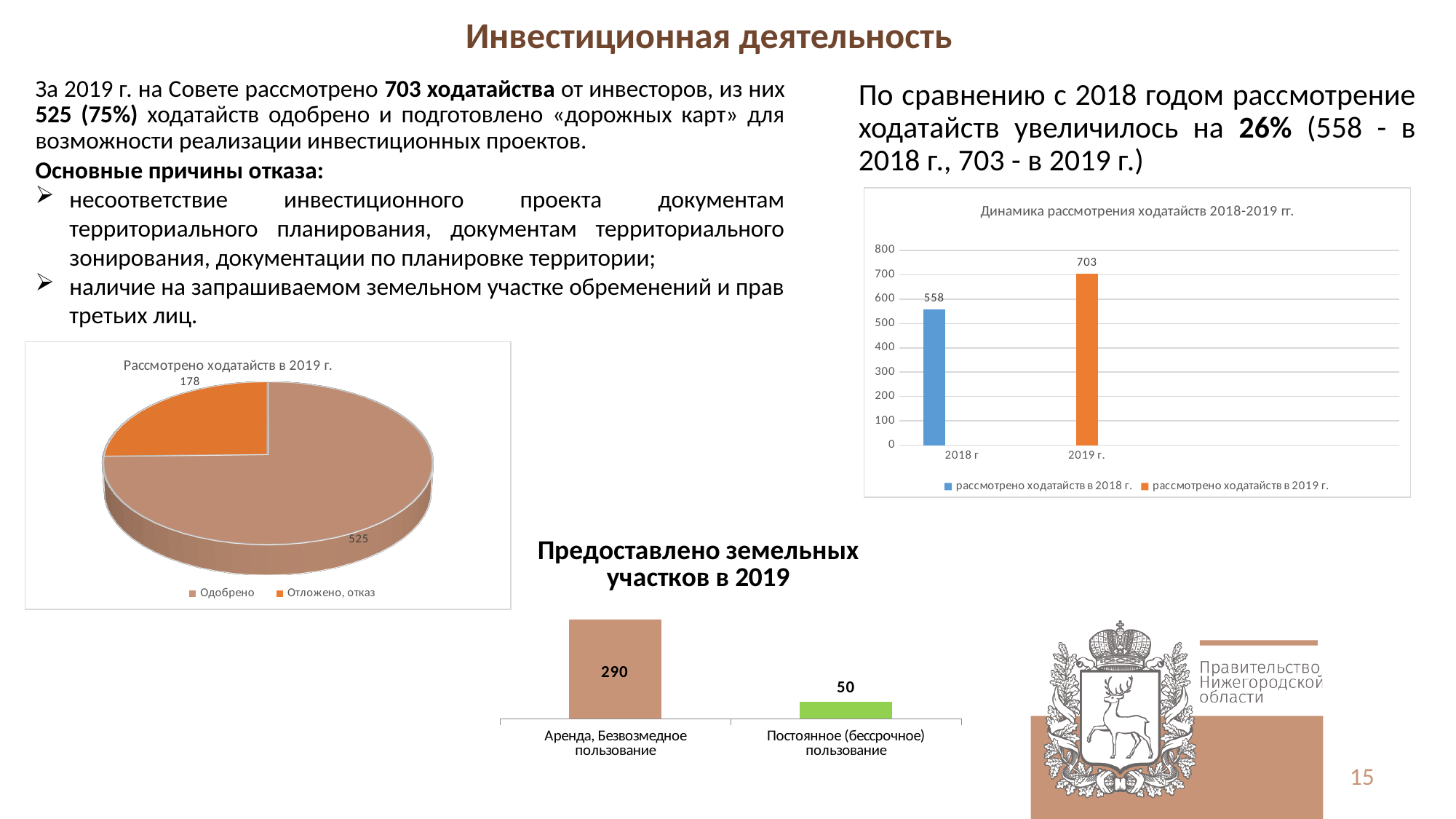
In the pie chart "Рассмотрено ходатайств в 2019 г.", how many entries does the legend list? 2 In the pie chart "Рассмотрено ходатайств в 2019 г.", what is the value for "Отложено, отказ"? 178 In the chart "Динамика рассмотрения ходатайств 2018-2019 гг.", do the values rise or fall from 2018 to 2019? rise In the pie chart "Рассмотрено ходатайств в 2019 г.", what is the total of the two slices? 703 In the chart "Предоставлено земельных участков в 2019", what is the value for "Аренда, Безвозмездное пользование"? 290 What kind of chart is "Динамика рассмотрения ходатайств 2018-2019 гг."? bar chart In the chart "Динамика рассмотрения ходатайств 2018-2019 гг.", what is the difference between the 2019 г. and 2018 г values? 145 In the chart "Предоставлено земельных участков в 2019", what is the difference between "Аренда, Безвозмездное пользование" and "Постоянное (бессрочное) пользование"? 240 In the pie chart "Рассмотрено ходатайств в 2019 г.", what is the value for "Одобрено"? 525 In the chart "Динамика рассмотрения ходатайств 2018-2019 гг.", what is the value for 2019 г.? 703 In the chart "Динамика рассмотрения ходатайств 2018-2019 гг.", what is the value for 2018 г? 558 In the pie chart "Рассмотрено ходатайств в 2019 г.", which slice is larger, "Одобрено" or "Отложено, отказ"? Одобрено